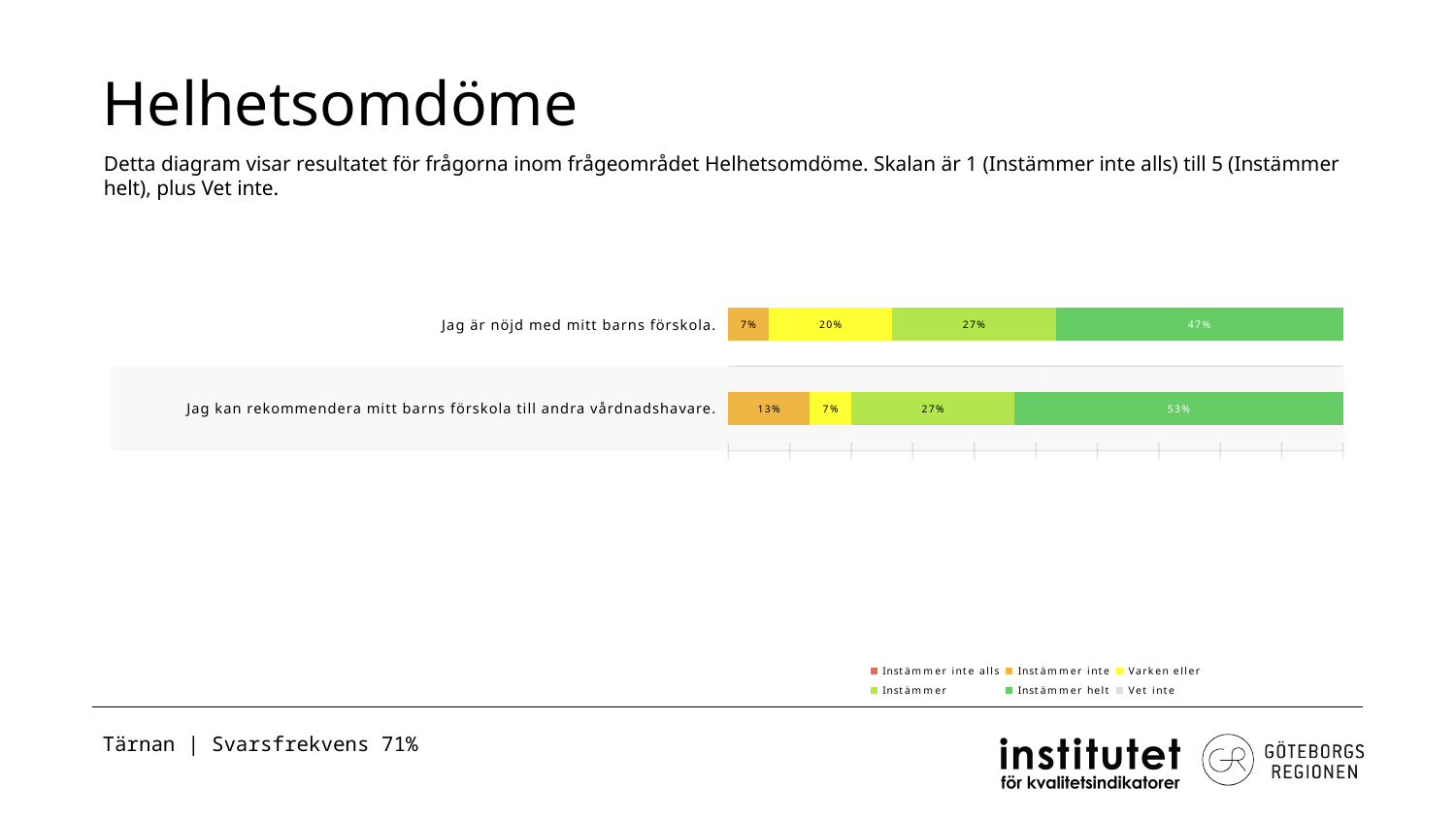
What is the 'Instämmer helt' share for 'Jag är nöjd med mitt barns förskola.'? 47% What is the 'Instämmer inte' share for 'Jag kan rekommendera mitt barns förskola till andra vårdnadshavare.'? 13% How many statements (categories) are plotted in the chart? 2 What is the difference in the 'Varken eller' share between 'Jag är nöjd med mitt barns förskola.' and 'Jag kan rekommendera mitt barns förskola till andra vårdnadshavare.'? 13% Which statement has the larger 'Instämmer helt' share? Jag kan rekommendera mitt barns förskola till andra vårdnadshavare. Which response category has the largest share for 'Jag är nöjd med mitt barns förskola.'? Instämmer helt What is the difference in the 'Instämmer helt' share between the two statements? 6% What is the 'Varken eller' share for 'Jag är nöjd med mitt barns förskola.'? 20% How many series does the chart legend list? 6 What is the 'Instämmer helt' share for 'Jag kan rekommendera mitt barns förskola till andra vårdnadshavare.'? 53% What kind of chart is shown on the slide? Stacked bar chart What is the title of the slide containing the chart? Helhetsomdöme